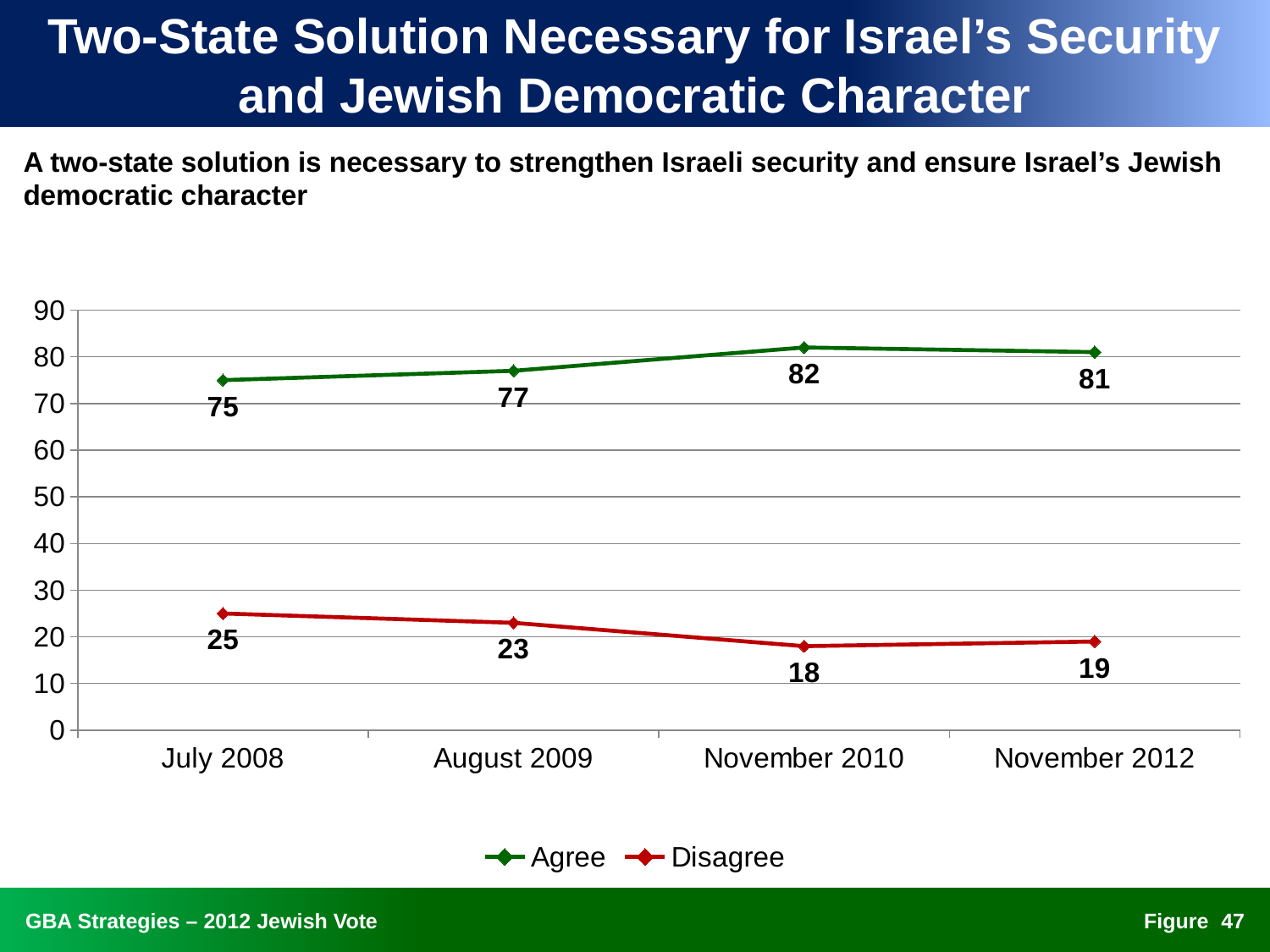
What kind of chart is shown on the slide? line chart What is the Disagree value for July 2008? 25 Which is larger, the Agree value in July 2008 or the Agree value in November 2012? November 2012 In which period is the Agree value highest? November 2010 What is the Agree value for November 2012? 81 What is the Agree value for November 2010? 82 In which period is the Disagree value lowest? November 2010 How many time periods are shown on the x axis? 4 Does the Disagree value rise or fall from July 2008 to November 2010? fall What is the difference between the Agree and Disagree values in August 2009? 54 How many series does the legend list? 2 What colour is the Agree line? green